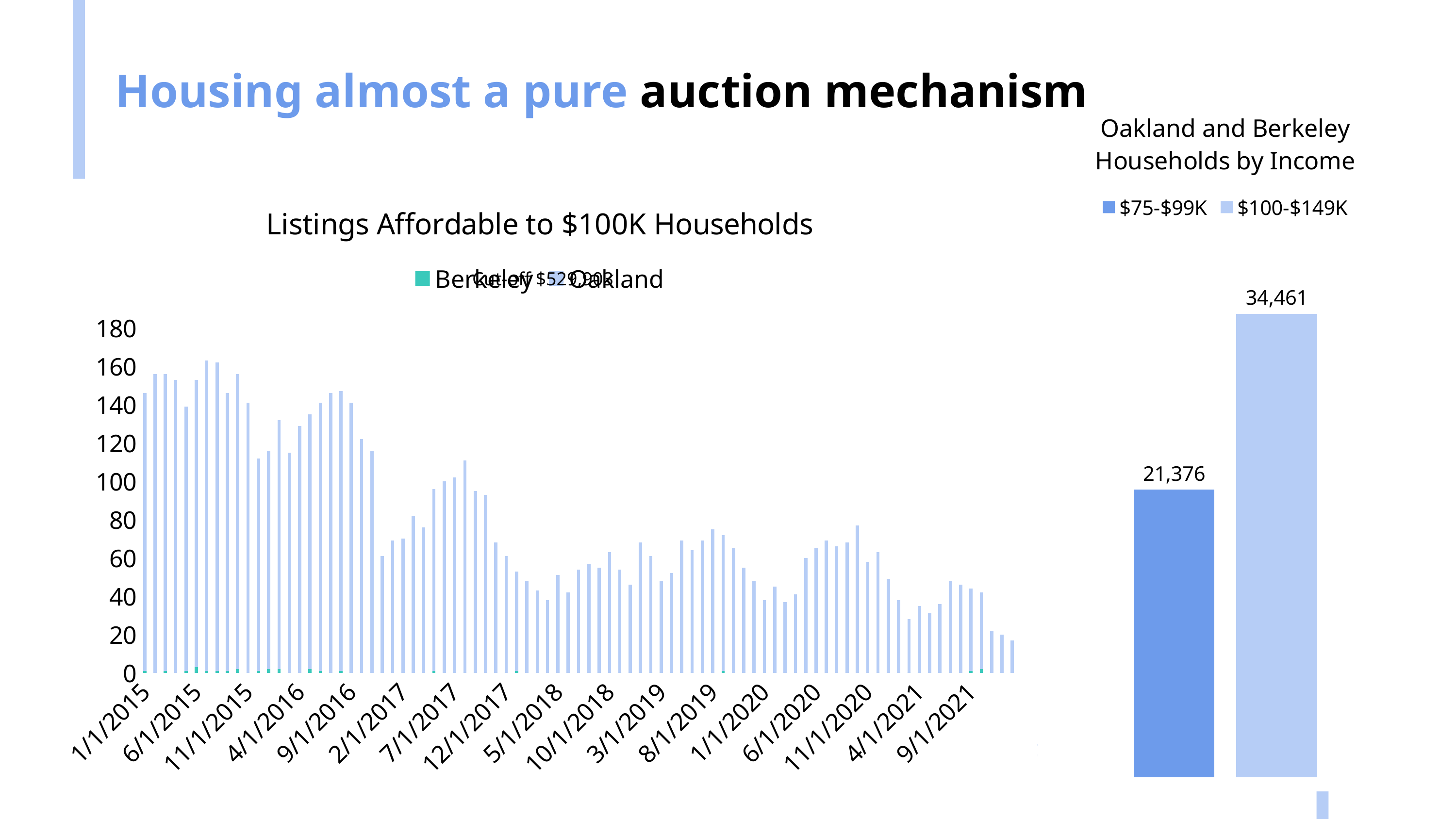
In the 'Oakland and Berkeley Households by Income' chart, how many income groups are shown? 2 What kind of chart is 'Oakland and Berkeley Households by Income'? Bar chart In the 'Listings Affordable to $100K Households' chart, what is the highest value shown on the vertical axis? 180 In the 'Oakland and Berkeley Households by Income' chart, what is the value for $75-$99K? 21,376 In the 'Listings Affordable to $100K Households' chart, is the value for 1/1/2015 greater or less than 120? greater What kind of chart is 'Listings Affordable to $100K Households'? Bar chart In the 'Oakland and Berkeley Households by Income' chart, what is the difference between the $100-$149K and $75-$99K values? 13,085 In the 'Listings Affordable to $100K Households' chart, is the value for 9/1/2021 greater or less than 80? less In the 'Listings Affordable to $100K Households' chart, do the values generally rise or fall from 2015 to 2021? Fall In the 'Oakland and Berkeley Households by Income' chart, which income group has the higher number of households? $100-$149K In the 'Oakland and Berkeley Households by Income' chart, what is the value for $100-$149K? 34,461 In the 'Oakland and Berkeley Households by Income' chart, which income group has the lower number of households? $75-$99K